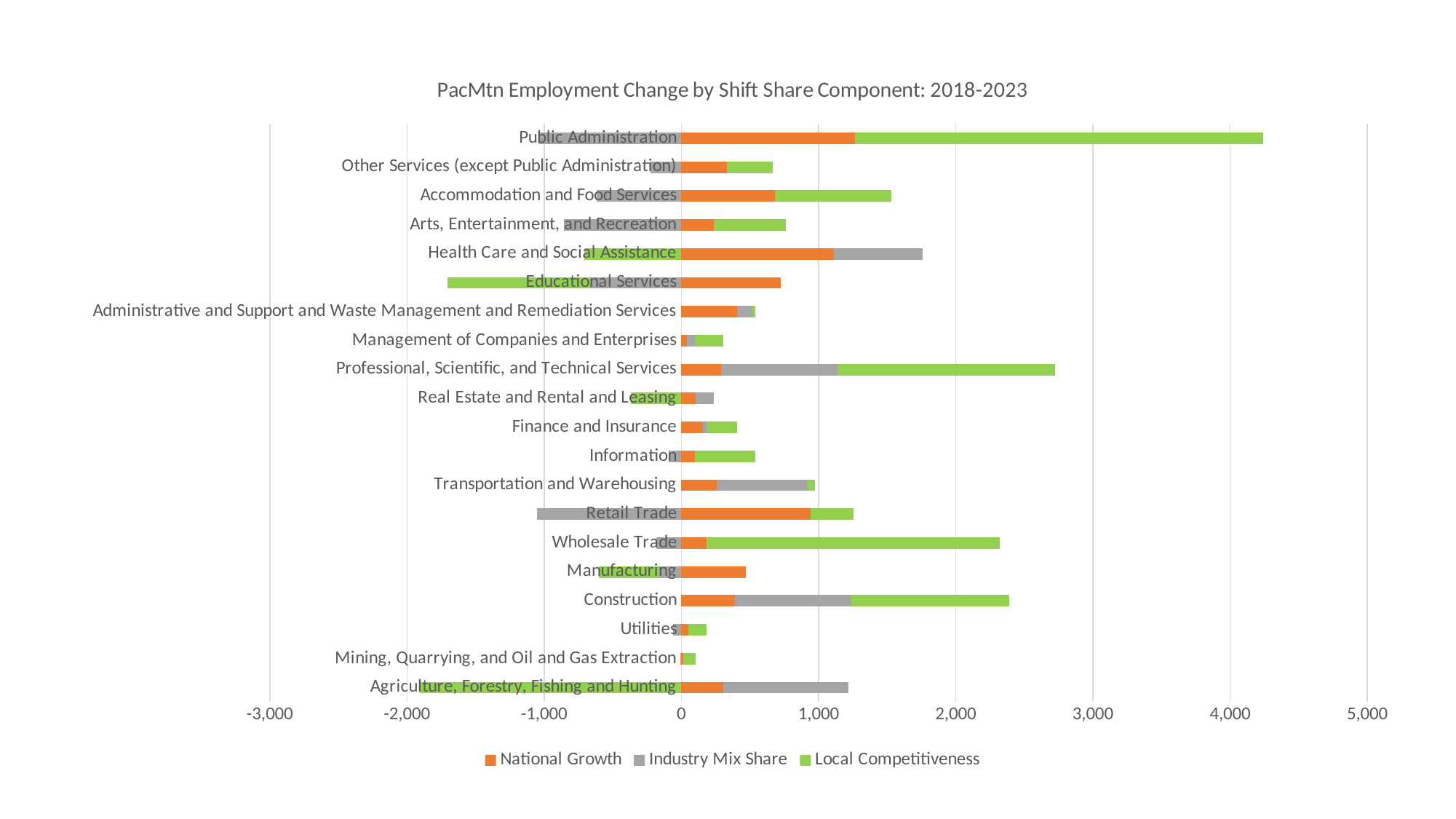
How many series does the legend list? 3 What kind of chart is shown on the slide? Stacked bar chart Which industry's stacked bar extends furthest to the right (largest positive total)? Public Administration What is the title of the chart? PacMtn Employment Change by Shift Share Component: 2018-2023 Which industry's bar extends furthest to the left (most negative value)? Agriculture, Forestry, Fishing and Hunting Is the right end of the Public Administration bar greater or less than 4,000? greater Which has the larger positive bar extent: Professional, Scientific, and Technical Services or Accommodation and Food Services? Professional, Scientific, and Technical Services Is the right end of the Construction bar greater or less than 2,000? greater Is the National Growth value for Public Administration greater or less than 1,000? greater Which series is shown in green in the legend? Local Competitiveness How many industry categories are plotted on the chart? 20